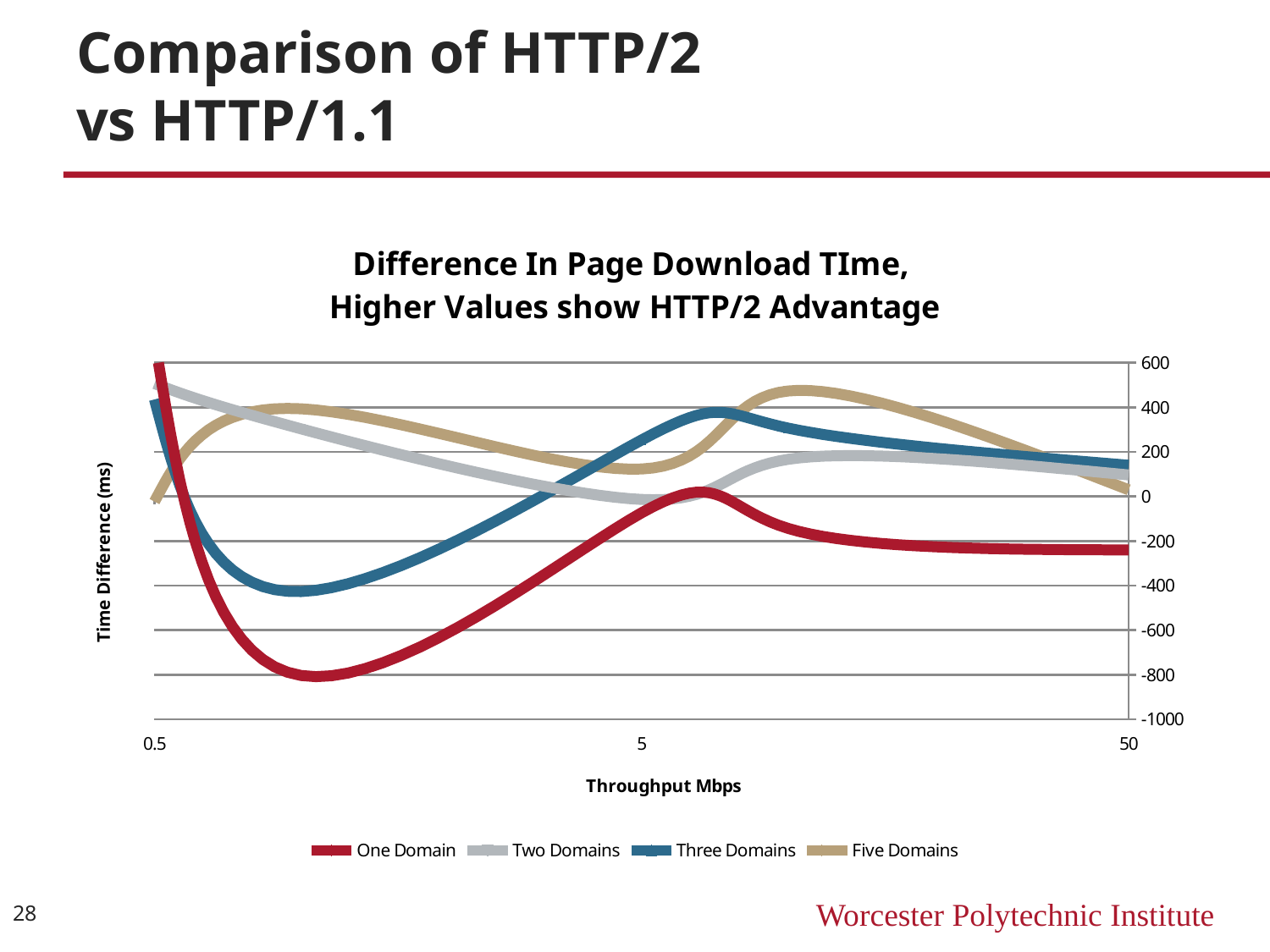
Is the value for Two Domains at 0.5 Mbps greater or less than 400? greater Does the Two Domains line rise or fall between 0.5 and 5 Mbps? fall Is the value for Five Domains at 5 Mbps greater or less than 0? greater How many tick labels are shown on the x axis? 3 Is the value for One Domain at 50 Mbps greater or less than 0? less At 50 Mbps, which is higher: Three Domains or One Domain? Three Domains What are the series names listed in the legend? One Domain, Two Domains, Three Domains, Five Domains Which series reaches the lowest value anywhere on the chart? One Domain What kind of chart is shown on the slide? line chart What is the title of the chart? Difference In Page Download TIme, Higher Values show HTTP/2 Advantage How many series does the legend list? 4